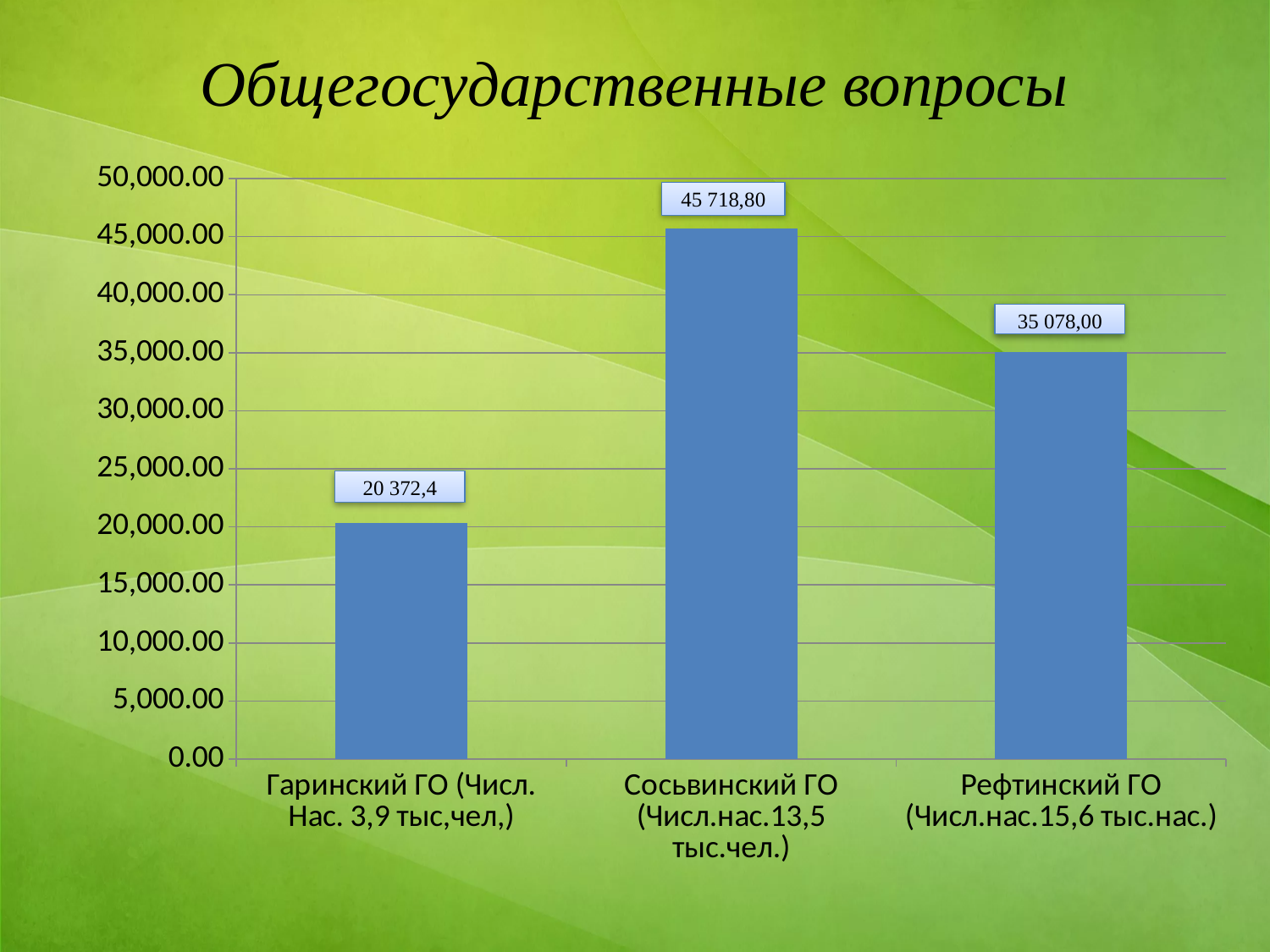
What is the value for Сосьвинский ГО? 45 718,80 What kind of chart is shown on the slide? bar chart Which category has the highest value? Сосьвинский ГО What is the value for Гаринский ГО? 20 372,4 Is the value for Сосьвинский ГО greater or less than 40,000.00? greater Which is larger, the value for Рефтинский ГО or the value for Гаринский ГО? Рефтинский ГО How many categories are shown in the chart? 3 What is the difference between the values for Рефтинский ГО and Гаринский ГО? 14 705,60 What is the value for Рефтинский ГО? 35 078,00 What is the title of the slide? Общегосударственные вопросы Which category has the lowest value? Гаринский ГО What is the difference between the values for Сосьвинский ГО and Рефтинский ГО? 10 640,80